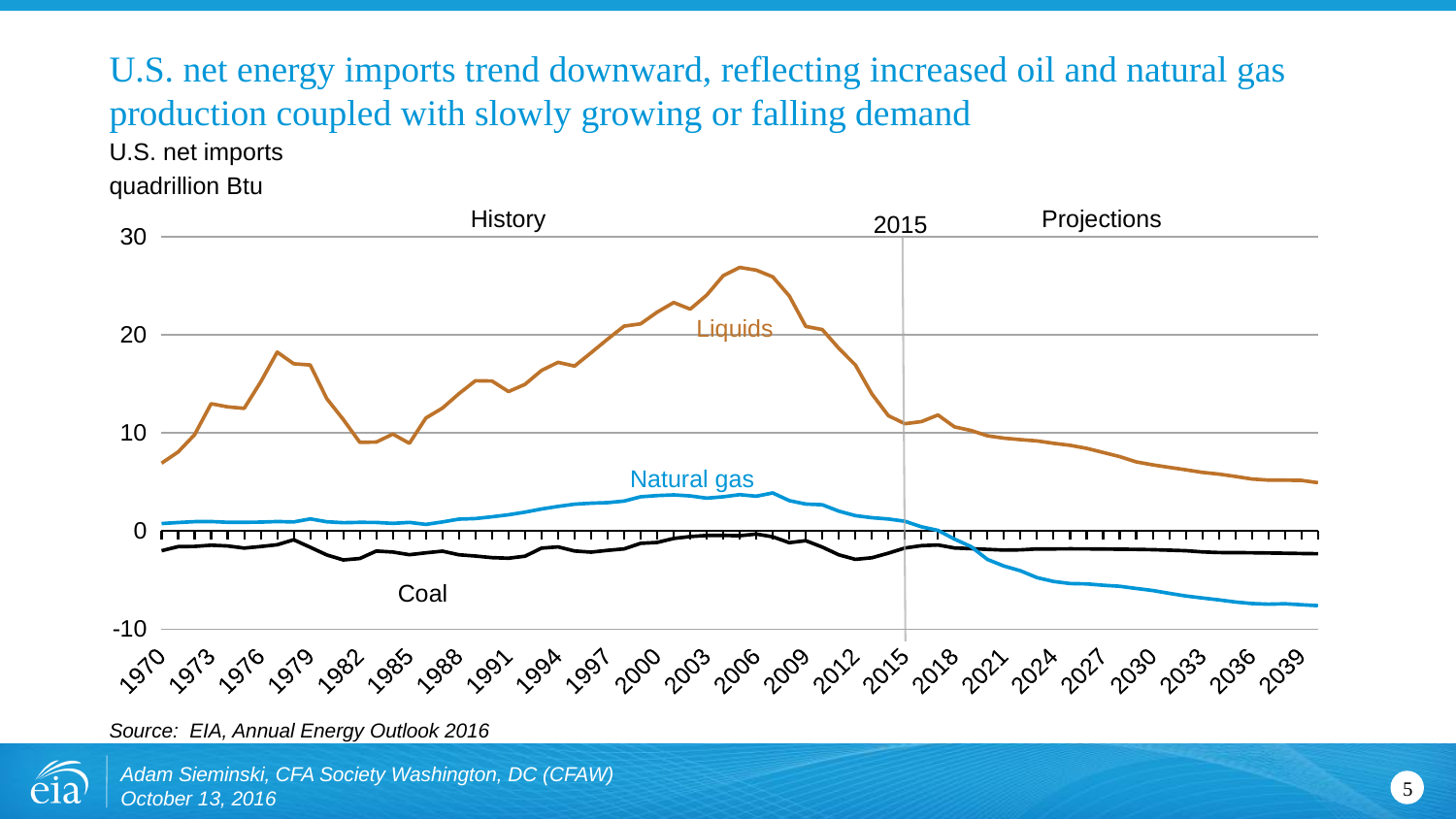
Is the value for Coal in 1970 greater or less than 0? less Which year does the vertical line separating History from Projections mark? 2015 Is the value for Natural gas in 2039 greater or less than 0? less Which is larger in 1970, the value for Liquids or the value for Natural gas? Liquids Which series has the lowest value in 2039? Natural gas Which series has the highest value in 2006? Liquids Is the value for Liquids in 2006 greater or less than 20? greater In what unit are the values on the chart measured? quadrillion Btu What kind of chart is shown on the slide? line chart Do the values for Liquids rise or fall from 2015 to 2039? fall How many data series are plotted on the chart? 3